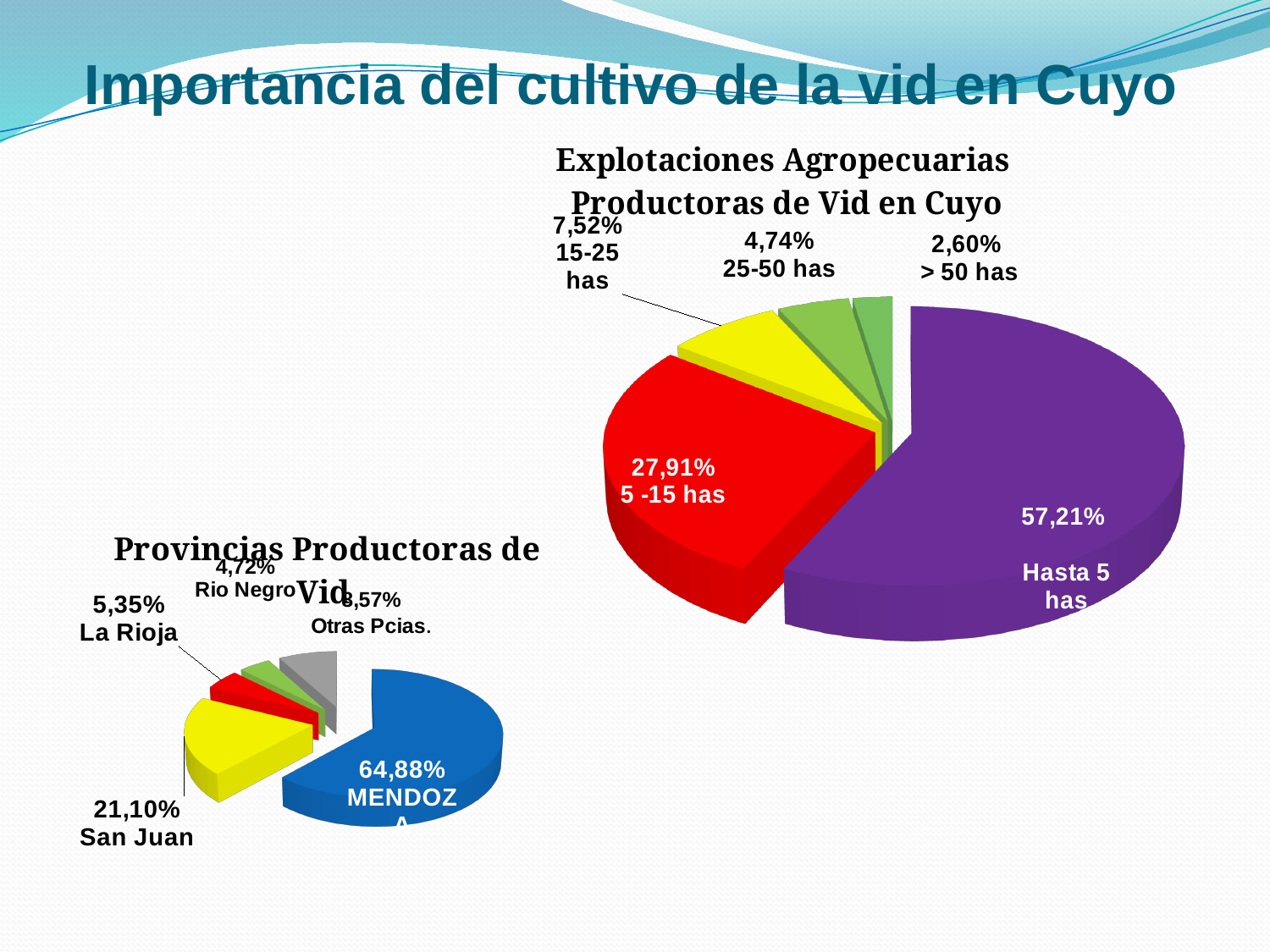
What type of chart is used for 'Provincias Productoras de Vid'? Pie chart In the chart titled 'Provincias Productoras de Vid', what percentage is shown for San Juan? 21,10% In the chart titled 'Explotaciones Agropecuarias Productoras de Vid en Cuyo', what percentage is shown for 'Hasta 5 has'? 57,21% In the chart titled 'Provincias Productoras de Vid', which is larger, La Rioja or Rio Negro? La Rioja In the chart titled 'Explotaciones Agropecuarias Productoras de Vid en Cuyo', which category has the smallest slice? > 50 has In the chart titled 'Explotaciones Agropecuarias Productoras de Vid en Cuyo', which category has the largest slice? Hasta 5 has In the chart titled 'Explotaciones Agropecuarias Productoras de Vid en Cuyo', what percentage is shown for '5 -15 has'? 27,91% In the chart titled 'Explotaciones Agropecuarias Productoras de Vid en Cuyo', what percentage is shown for '> 50 has'? 2,60% In the chart titled 'Provincias Productoras de Vid', what percentage is shown for MENDOZA? 64,88% In the chart titled 'Explotaciones Agropecuarias Productoras de Vid en Cuyo', how many slices does the pie have? 5 In the chart titled 'Explotaciones Agropecuarias Productoras de Vid en Cuyo', what is the difference in percentage points between 'Hasta 5 has' and '5 -15 has'? 29,30 In the chart titled 'Provincias Productoras de Vid', which province has the largest slice? MENDOZA